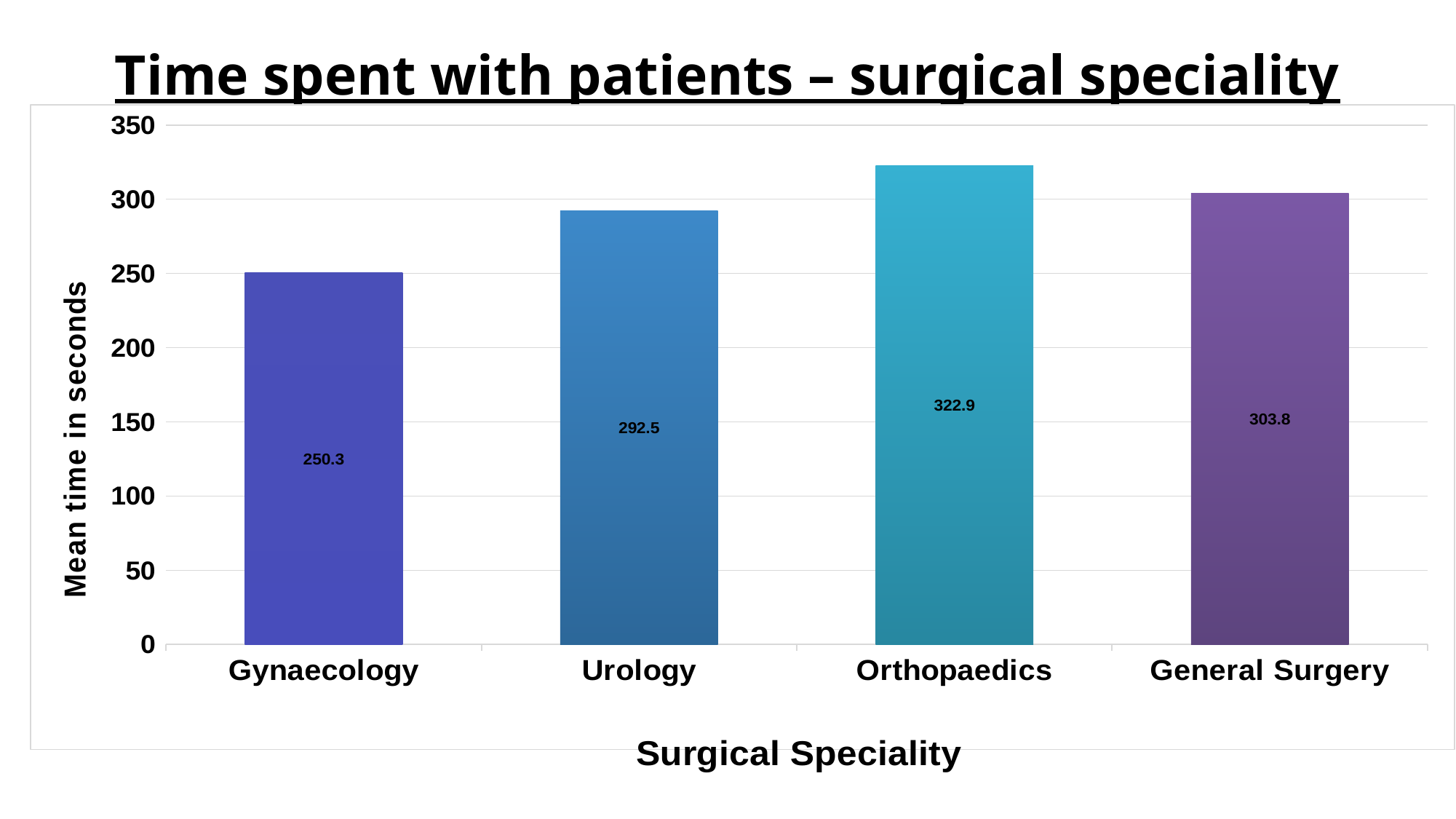
What kind of chart is shown on the slide? bar chart What is the mean time in seconds for Orthopaedics? 322.9 Which surgical speciality has the highest mean time spent with patients? Orthopaedics Is the value for Gynaecology greater or less than 300? less How many surgical specialities are shown on the chart? 4 What is the mean time in seconds for General Surgery? 303.8 What is the difference in mean time between General Surgery and Urology? 11.3 Which has a larger mean time, Urology or General Surgery? General Surgery What is the mean time in seconds for Urology? 292.5 Which surgical speciality has the lowest mean time spent with patients? Gynaecology What is the difference in mean time between Orthopaedics and Gynaecology? 72.6 What is the mean time in seconds for Gynaecology? 250.3